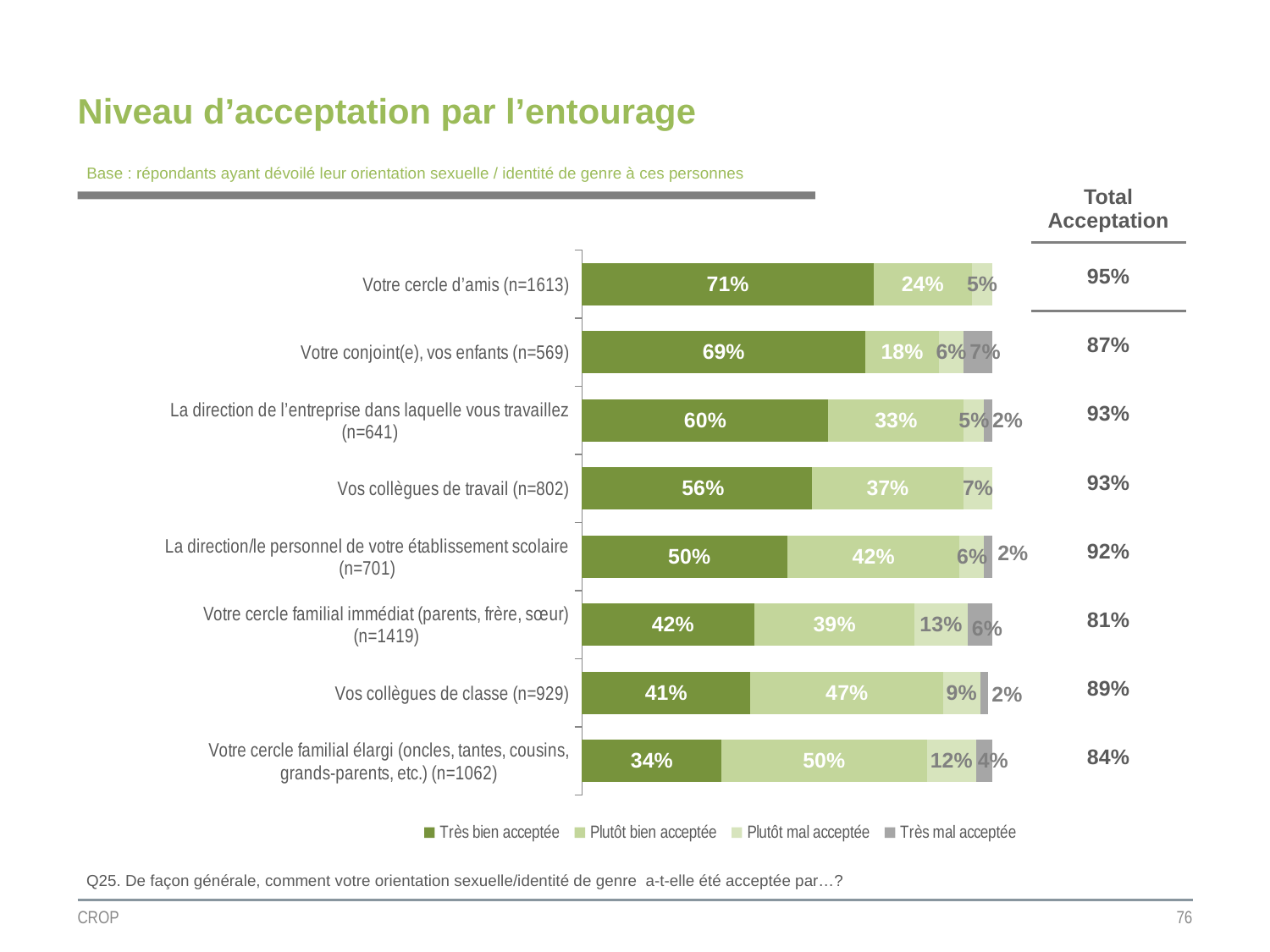
What is the 'Très mal acceptée' value for 'Votre conjoint(e), vos enfants (n=569)'? 7% What type of chart is shown on the slide? Stacked bar chart What is the 'Plutôt bien acceptée' value for 'Vos collègues de classe (n=929)'? 47% What is the 'Très bien acceptée' value for 'Votre cercle d'amis (n=1613)'? 71% How many categories (groups of people) are plotted in the chart? 8 How many series does the legend list? 4 What is the difference between the 'Très bien acceptée' values for 'Votre cercle d'amis (n=1613)' and 'Vos collègues de travail (n=802)'? 15% What is the 'Total Acceptation' value shown for 'Votre cercle familial immédiat (parents, frère, sœur) (n=1419)'? 81% Which category has the highest 'Très bien acceptée' value? Votre cercle d'amis (n=1613) Which category has the lowest 'Très bien acceptée' value? Votre cercle familial élargi (oncles, tantes, cousins, grands-parents, etc.) (n=1062) What is the 'Plutôt mal acceptée' value for 'Votre cercle familial immédiat (parents, frère, sœur) (n=1419)'? 13% Which is larger: the 'Plutôt bien acceptée' value for 'Votre cercle familial élargi (n=1062)' or for 'La direction/le personnel de votre établissement scolaire (n=701)'? Votre cercle familial élargi (n=1062)